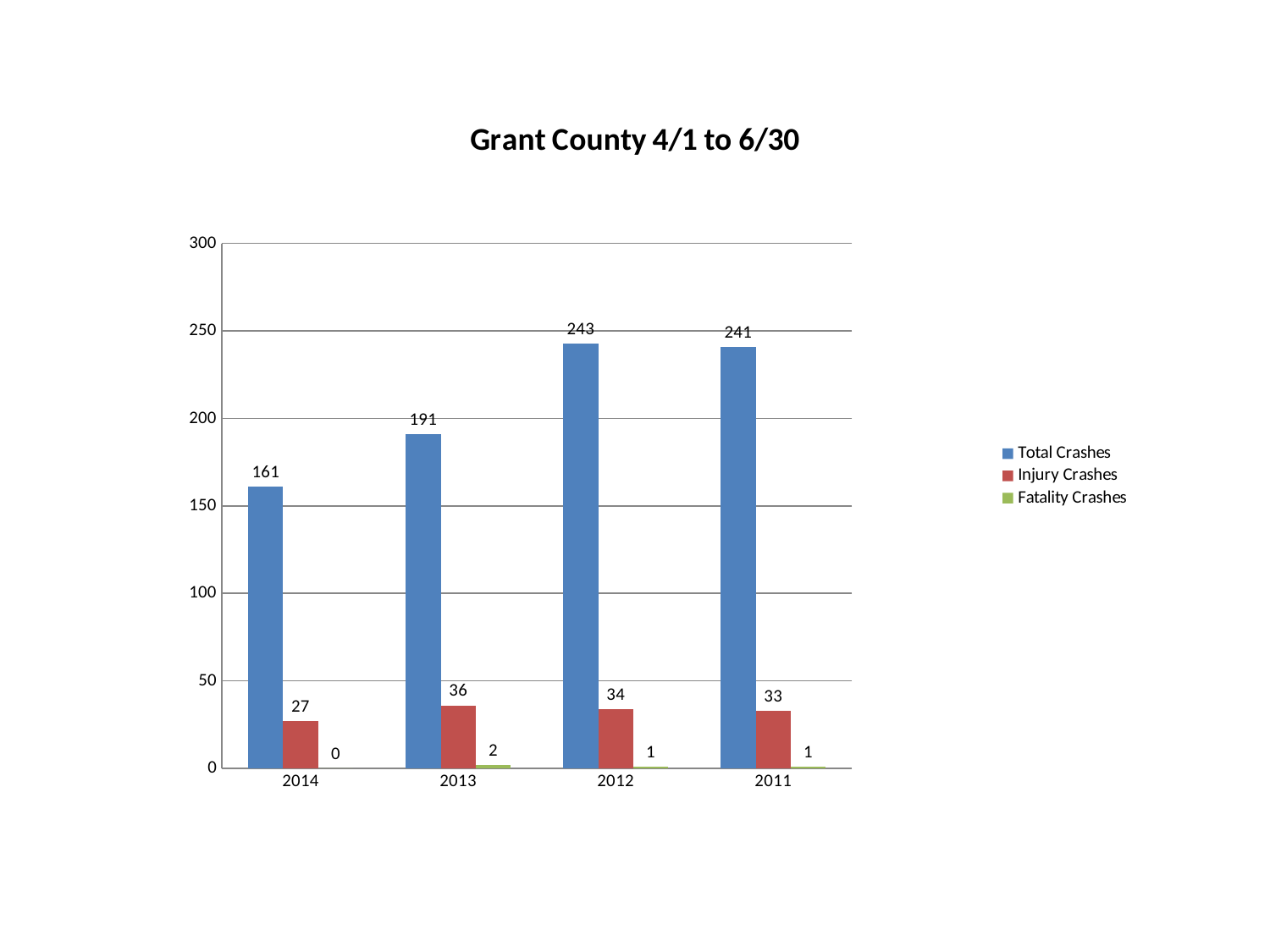
What is the value of Total Crashes for 2014? 161 Which year has the highest Total Crashes? 2012 What kind of chart is shown on the slide? bar chart What is the title of the chart? Grant County 4/1 to 6/30 How many series does the legend list? 3 Which year has the lowest Injury Crashes? 2014 What is the value of Injury Crashes for 2013? 36 Which is larger, Injury Crashes in 2012 or Injury Crashes in 2011? 2012 How many years are shown on the x axis? 4 What is the value of Fatality Crashes for 2012? 1 What is the difference in Total Crashes between 2013 and 2014? 30 Is the value of Total Crashes for 2013 greater or less than 200? less